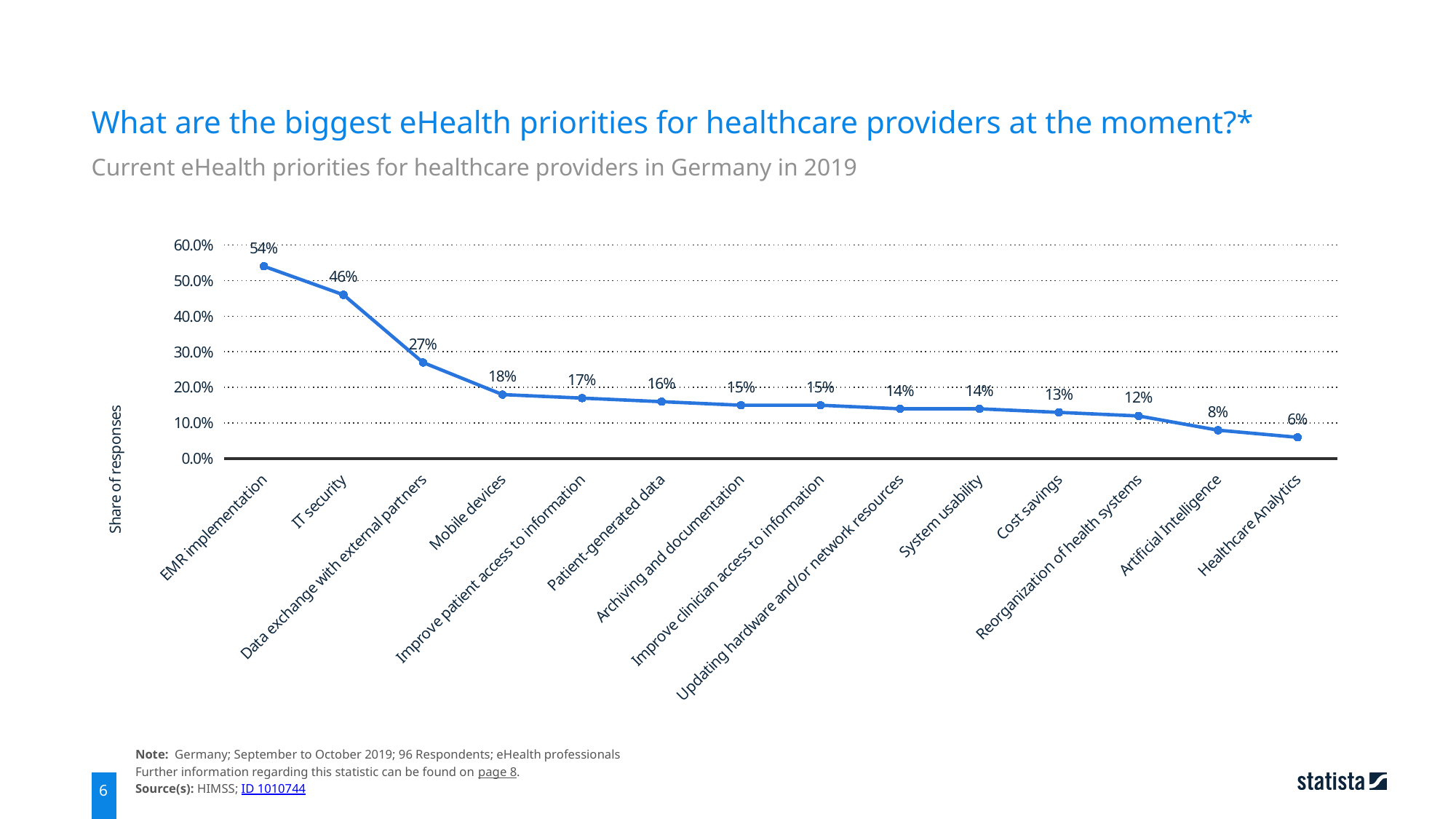
Do the values rise or fall from left to right along the x axis? Fall Which priority has the lowest share of responses? Healthcare Analytics What is the label of the vertical axis? Share of responses What is the share of responses for EMR implementation? 54% What is the share of responses for Artificial Intelligence? 8% How many priorities are plotted on the chart? 14 What is the share of responses for Mobile devices? 18% What kind of chart is shown on the slide? Line chart Is the value for Data exchange with external partners greater or less than 30.0%? less What is the difference between the shares for IT security and Data exchange with external partners? 19% Which priority has the highest share of responses? EMR implementation Which has a larger share of responses, Cost savings or Reorganization of health systems? Cost savings